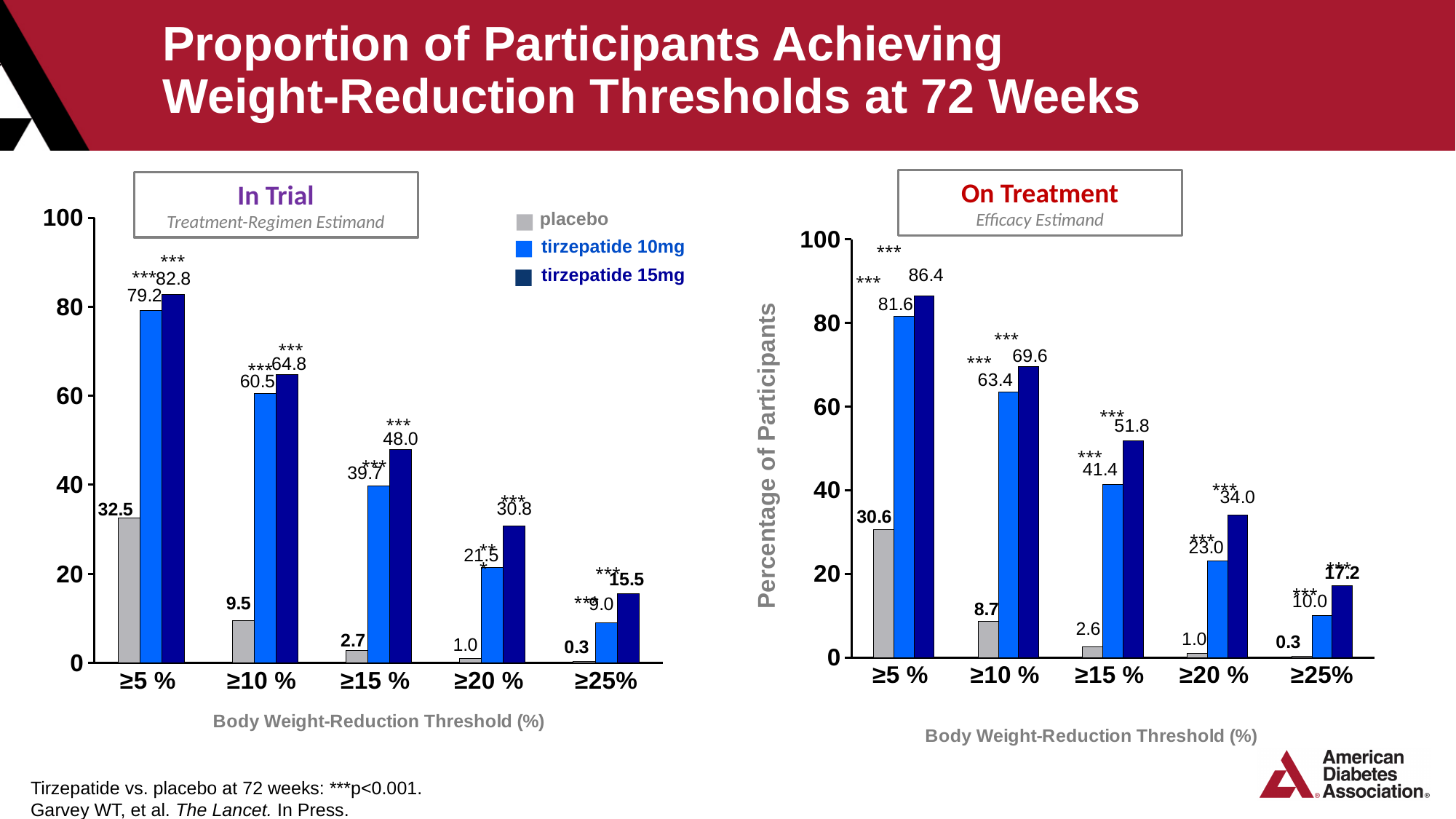
In the On Treatment chart, what is the difference between tirzepatide 15mg and placebo at the ≥5 % threshold? 55.8 In the In Trial chart, which is larger at the ≥20 % threshold: tirzepatide 10mg or tirzepatide 15mg? tirzepatide 15mg How many threshold categories are shown on the x axis of the On Treatment chart? 5 In the On Treatment chart, do the tirzepatide 15mg values rise or fall as the threshold increases along the x axis? fall In the In Trial chart, which threshold category has the highest value for tirzepatide 10mg? ≥5 % In the On Treatment chart, what is the value for placebo at the ≥10 % threshold? 8.7 In the In Trial chart, what is the difference between tirzepatide 15mg and tirzepatide 10mg at the ≥15 % threshold? 8.3 In the In Trial chart, what is the value for tirzepatide 15mg at the ≥5 % threshold? 82.8 What type of chart is the In Trial chart? bar chart In the On Treatment chart, which threshold category has the lowest value for placebo? ≥25% In the On Treatment chart, what is the value for tirzepatide 10mg at the ≥15 % threshold? 41.4 How many series does the legend list? 3